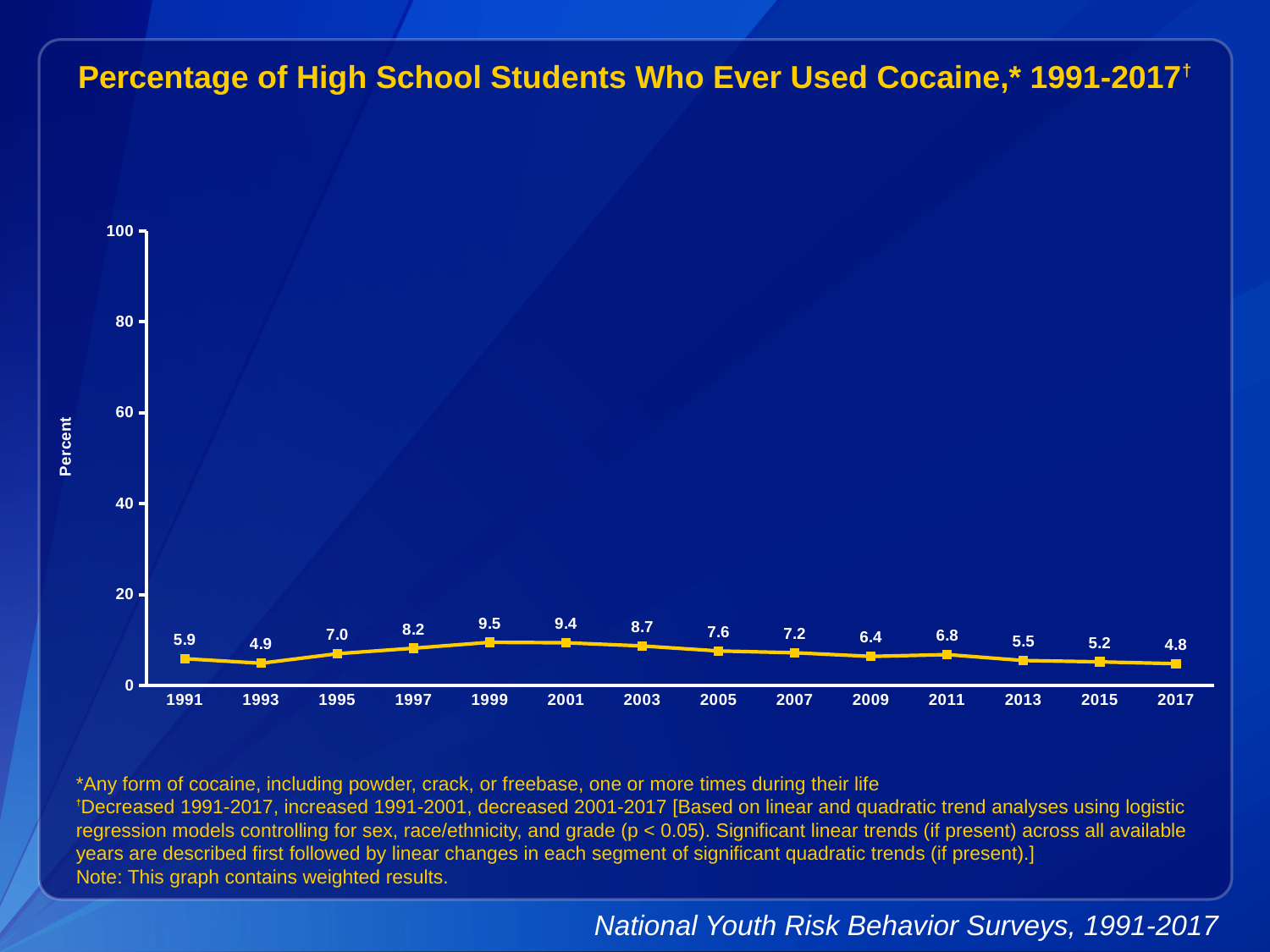
Do the values rise or fall from 2001 to 2017? fall Which year has the lowest percentage of students who ever used cocaine? 2017 How many years are plotted on the x axis? 14 What kind of chart is shown on the slide? line chart What is the difference between the values for 1999 and 2017? 4.7 What is the value plotted for 2017? 4.8 What percentage of high school students had ever used cocaine in 1999? 9.5 Is the value for 2001 greater or less than 20? less Which year has the highest percentage of students who ever used cocaine? 1999 What is the label on the y axis? Percent Which year has a larger value, 2003 or 2011? 2003 What is the value plotted for 1991? 5.9